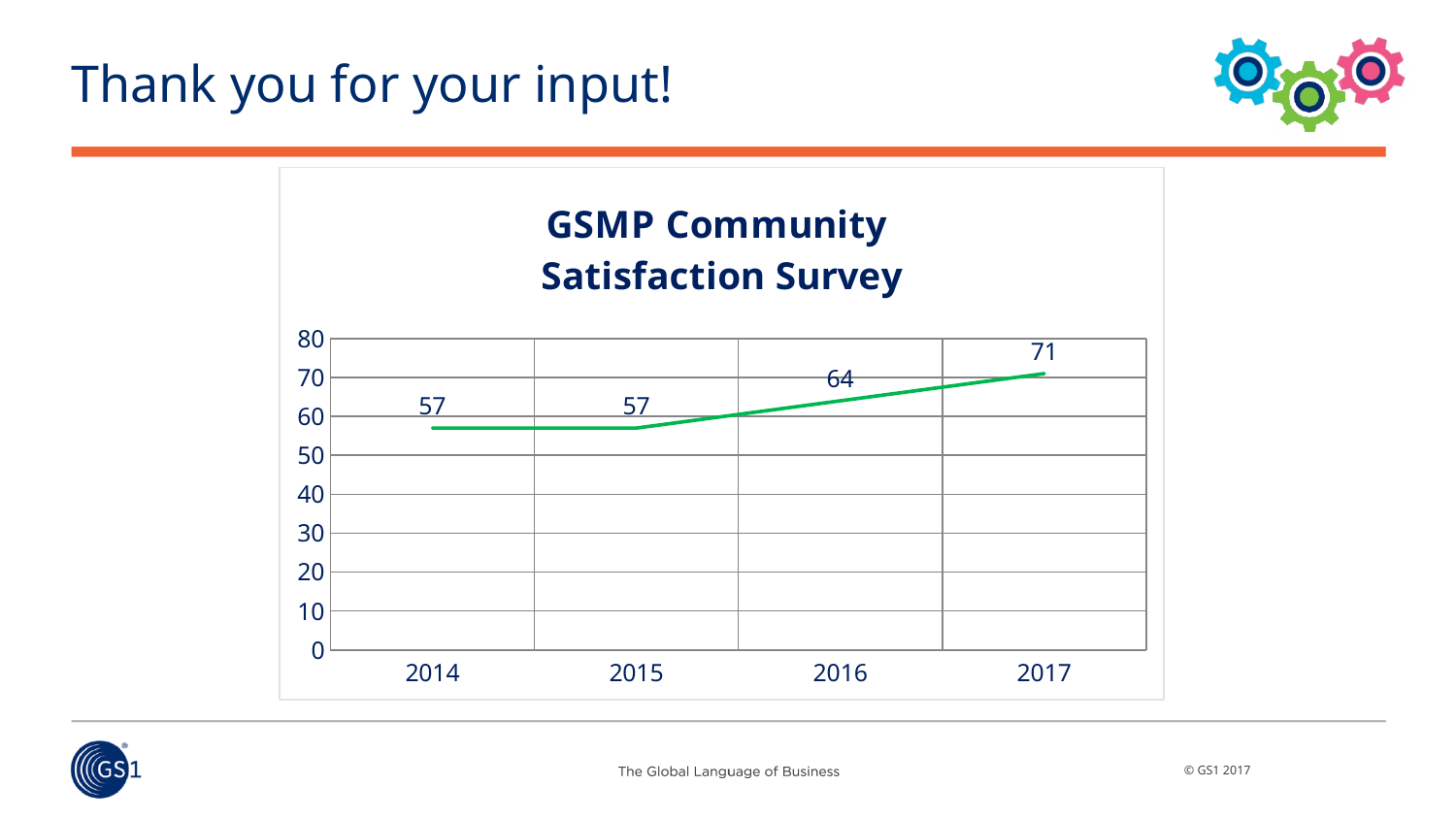
Is the value for 2017 in the GSMP Community Satisfaction Survey chart greater or less than 60? greater Do the values in the GSMP Community Satisfaction Survey chart rise or fall from 2015 to 2017? rise What is the value for 2014 in the GSMP Community Satisfaction Survey chart? 57 What is the value for 2017 in the GSMP Community Satisfaction Survey chart? 71 Which year has the highest value in the GSMP Community Satisfaction Survey chart? 2017 What is the value for 2016 in the GSMP Community Satisfaction Survey chart? 64 What is the title of the chart on the slide? GSMP Community Satisfaction Survey What is the difference between the 2017 and 2014 values in the GSMP Community Satisfaction Survey chart? 14 Which is larger in the GSMP Community Satisfaction Survey chart, the value for 2016 or the value for 2017? 2017 What is the difference between the 2016 and 2015 values in the GSMP Community Satisfaction Survey chart? 7 How many years are plotted in the GSMP Community Satisfaction Survey chart? 4 What kind of chart is the GSMP Community Satisfaction Survey chart? line chart